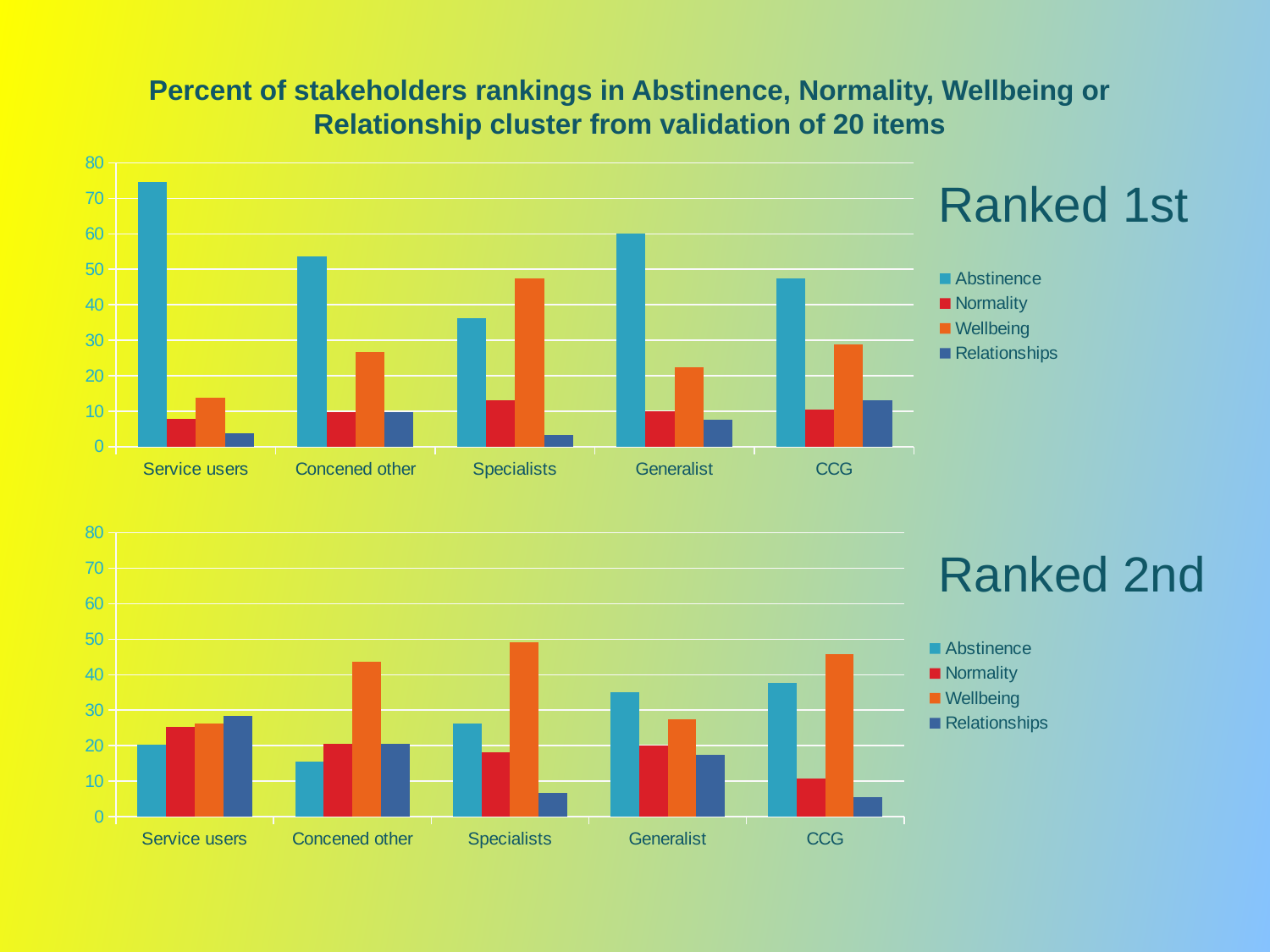
In the 'Ranked 1st' chart, which series has the highest value for Specialists? Wellbeing In the 'Ranked 2nd' chart, is the Relationships value for CCG greater or less than 10? less What kind of chart is the 'Ranked 1st' chart? bar chart In the 'Ranked 1st' chart, which is larger for Generalist: Abstinence or Wellbeing? Abstinence In the 'Ranked 1st' chart, which category has the highest Abstinence value? Service users In the 'Ranked 2nd' chart, which is larger for Concened other: Abstinence or Wellbeing? Wellbeing In the 'Ranked 1st' chart, is the Abstinence value for Service users greater or less than 70? greater How many stakeholder categories are shown on the x axis of the 'Ranked 2nd' chart? 5 In the 'Ranked 2nd' chart, which series has the lowest value for Specialists? Relationships In the 'Ranked 1st' chart, is the Wellbeing value for Specialists greater or less than 40? greater How many series does the legend of the 'Ranked 1st' chart list? 4